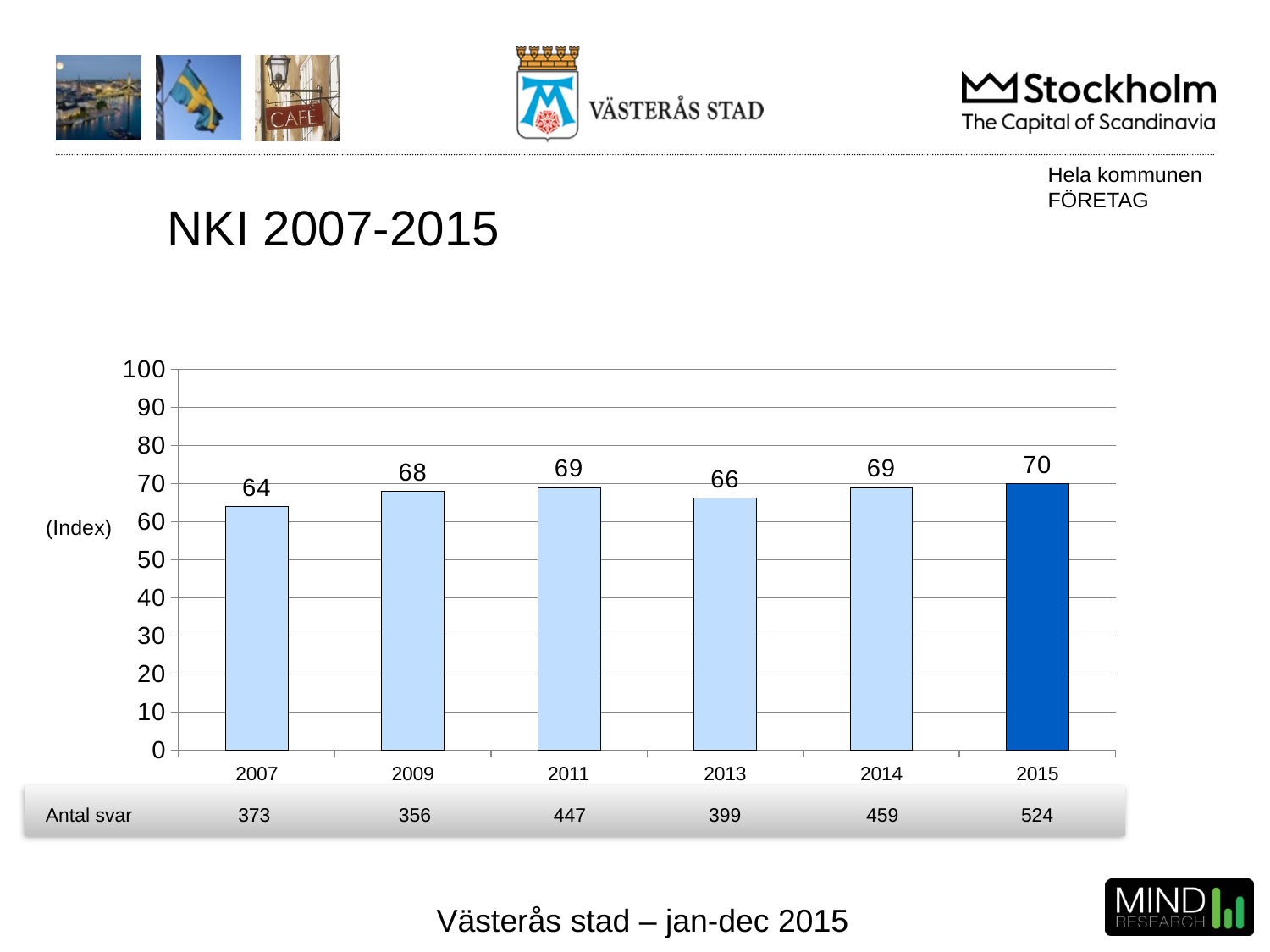
Which is larger, the NKI index value for 2009 or for 2013? 2009 Which year has the highest NKI index value? 2015 What is the NKI index value for 2013? 66 What is the number of responses (Antal svar) for 2015? 524 What is the NKI index value for 2015? 70 Which year has the lowest NKI index value? 2007 What is the difference between the NKI index values for 2015 and 2007? 6 Is the NKI index value for 2011 greater or less than 60? greater What is the title of the chart? NKI 2007-2015 How many years are shown on the x axis of the chart? 6 What kind of chart is shown on the slide? bar chart What is the NKI index value for 2007? 64